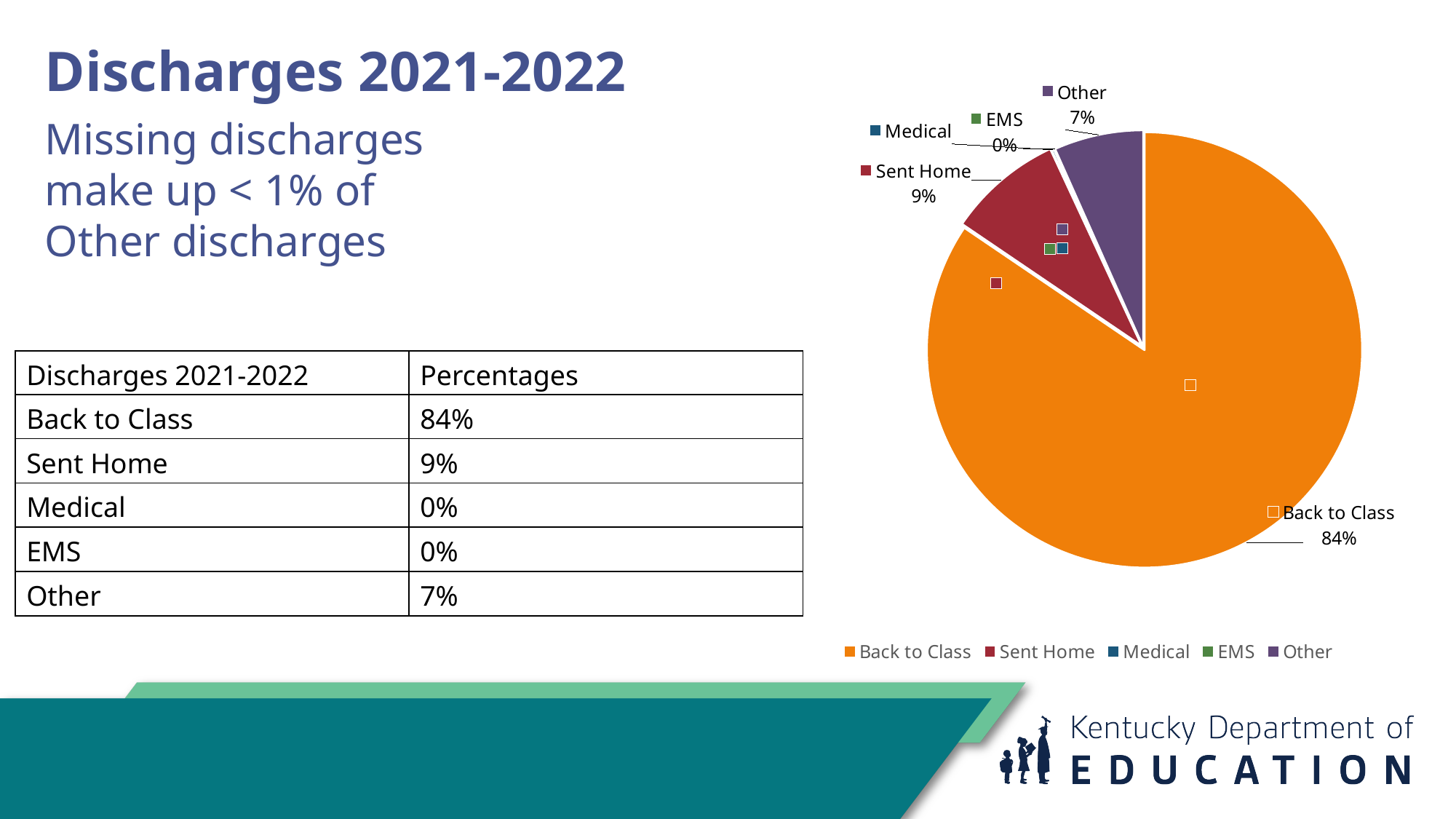
What colour is the Back to Class slice of the pie chart? orange Which is larger, the share for Sent Home or the share for Other? Sent Home What is the difference in percentage points between Back to Class and Sent Home? 75 What kind of chart is shown on the slide? pie chart What percentage of discharges is Sent Home? 9% Which discharge category has the largest share of the pie? Back to Class What is the difference in percentage points between Sent Home and Other? 2 What percentage of discharges is EMS? 0% What percentage of discharges is Back to Class? 84% What percentage of discharges is Other? 7% Which two categories in the pie chart are labelled 0%? Medical and EMS How many categories does the legend of the pie chart list? 5